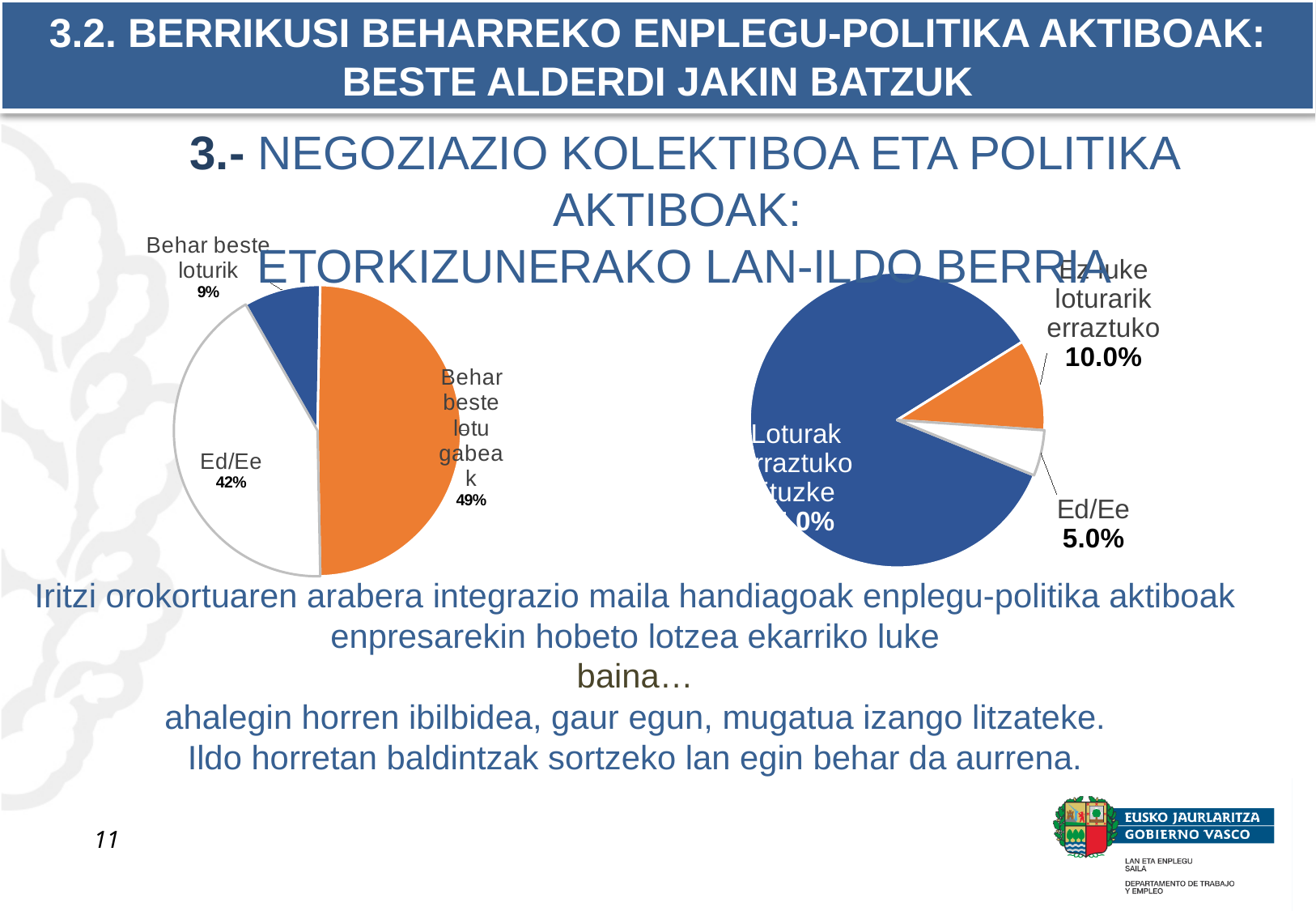
In the right pie chart, which is larger: "Ez luke loturarik erraztuko" or "Ed/Ee"? Ez luke loturarik erraztuko In the left pie chart, what percentage is shown for "Behar beste lotu gabeak"? 49% In the right pie chart, which category has the largest share? Loturak erraztuko lituzke In the left pie chart, which category has the smallest share? Behar beste loturik In the left pie chart, what is the difference in percentage points between "Behar beste lotu gabeak" and "Ed/Ee"? 7 In the right pie chart, what percentage is shown for "Ez luke loturarik erraztuko"? 10.0% In the right pie chart, what percentage is shown for "Ed/Ee"? 5.0% What type of chart is the left chart on the slide? Pie chart In the left pie chart, what percentage is shown for "Ed/Ee"? 42% In the left pie chart, which category has the largest share? Behar beste lotu gabeak In the right pie chart, which category has the smallest share? Ed/Ee In the left pie chart, what percentage is shown for "Behar beste loturik"? 9%